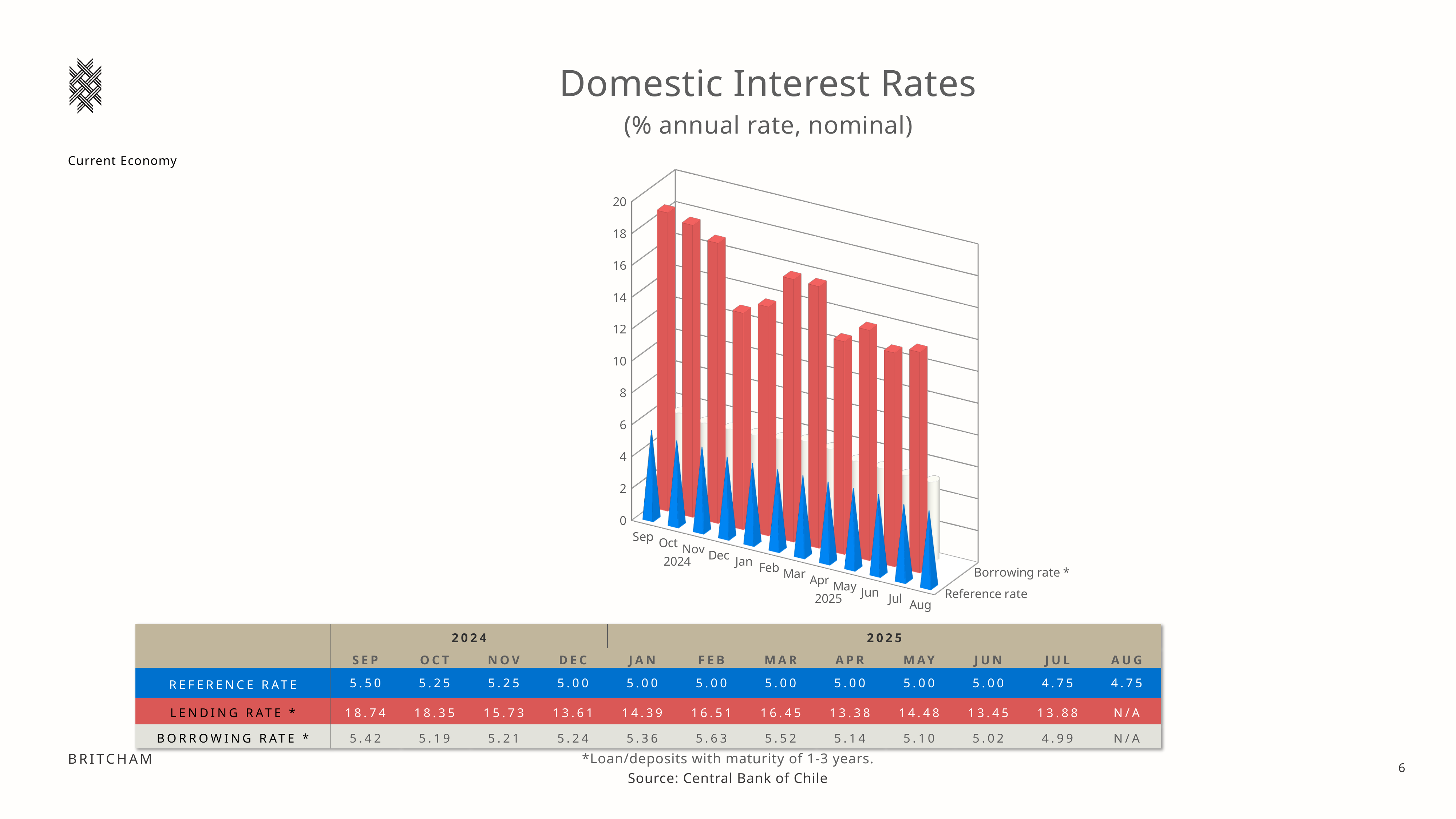
How many months are plotted along the x axis of the chart? 12 What kind of chart is shown on the slide? bar chart What is the lending rate for Sep 2024? 18.74 In which month is the lending rate lowest? Apr 2025 What is the reference rate for Jul 2025? 4.75 Is the lending rate for Nov 2024 greater or less than 14? greater What is the difference between the lending rate in Sep 2024 and Oct 2024? 0.39 What is the borrowing rate for Feb 2025? 5.63 What is the title of the chart? Domestic Interest Rates Which is larger, the lending rate in Jan 2025 or in Feb 2025? Feb 2025 In which month is the lending rate highest? Sep 2024 Does the lending rate generally rise or fall from Sep 2024 to Jul 2025? fall